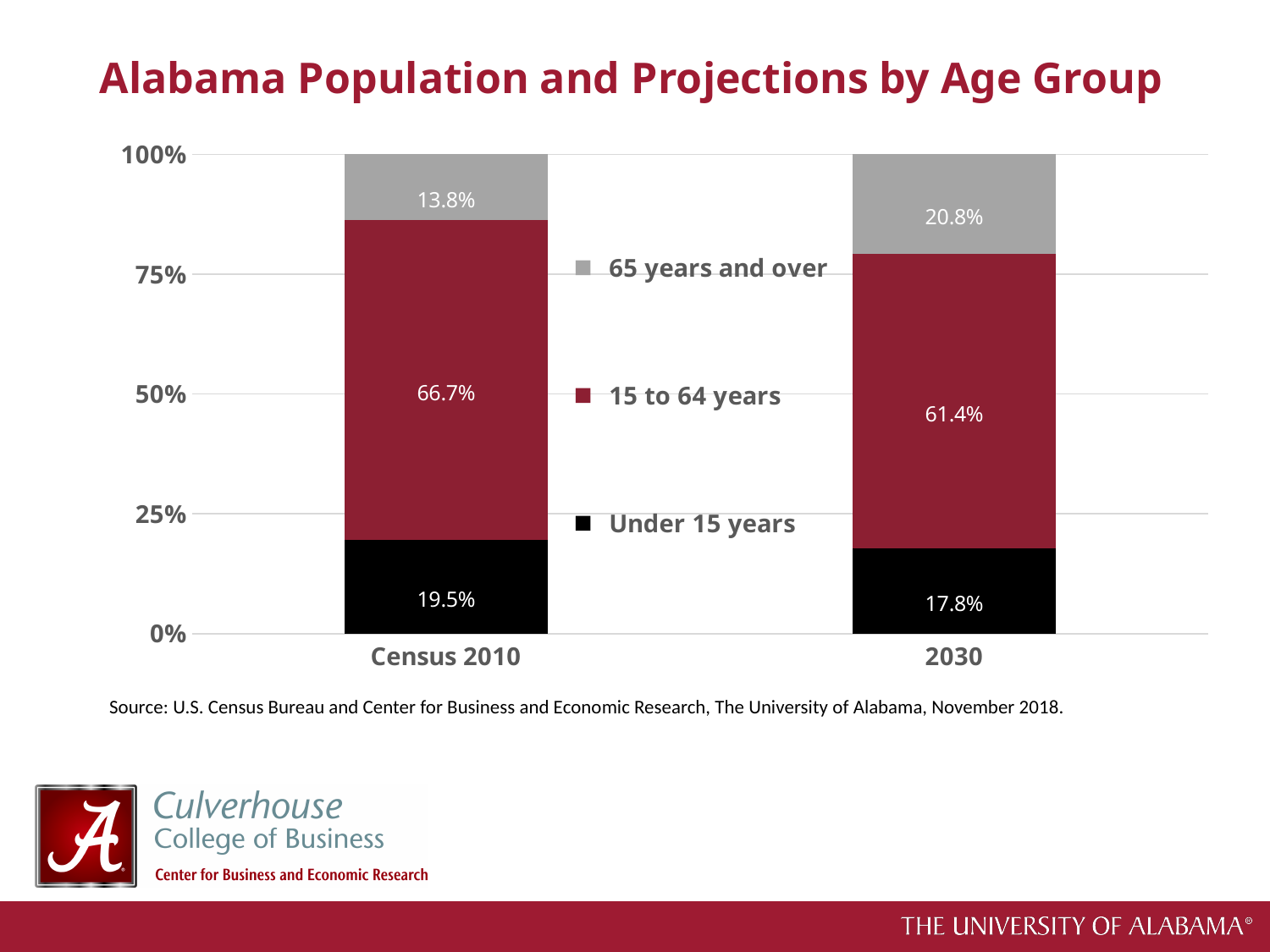
What is the projected share of the 15 to 64 years age group in 2030? 61.4% What is the projected share of the population aged 65 years and over in 2030? 20.8% By how many percentage points is the 65 years and over share projected to change from Census 2010 to 2030? 7.0 percentage points Does the share of the under 15 years group rise or fall from Census 2010 to 2030? Fall What share of Alabama's population was aged 65 years and over in Census 2010? 13.8% What colour represents the 15 to 64 years age group? Crimson (dark red) What type of chart is shown on the slide? Stacked bar chart Is the share of the 15 to 64 years group larger in Census 2010 or in 2030? Census 2010 Which age group has the largest share in Census 2010? 15 to 64 years How many series does the legend list? 3 Which age group has the smallest projected share in 2030? Under 15 years What share of the population was under 15 years in Census 2010? 19.5%